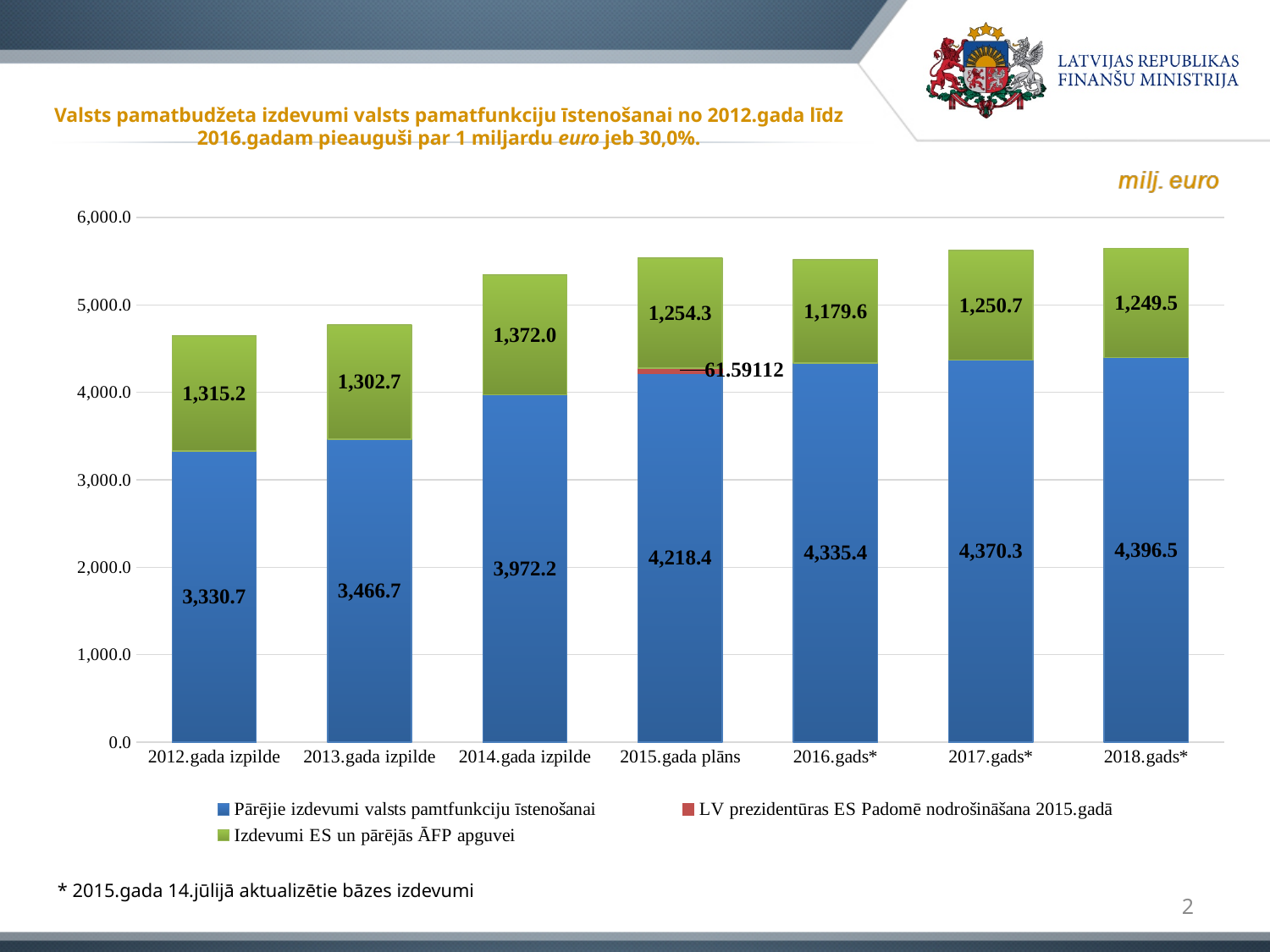
What is the total of the stacked bar for 2012.gada izpilde? 4,645.9 In which category is 'Izdevumi ES un pārējās ĀFP apguvei' highest? 2014.gada izpilde What is the value of 'Izdevumi ES un pārējās ĀFP apguvei' for 2017.gads*? 1,250.7 What is the value of 'LV prezidentūras ES Padomē nodrošināšana 2015.gadā' for 2015.gada plāns? 61.59112 What is the total of the stacked bar for 2016.gads*? 5,515.0 How many series does the legend list? 3 What is the difference between 'Pārējie izdevumi valsts pamtfunkciju īstenošanai' in 2018.gads* and in 2012.gada izpilde? 1,065.8 How many categories are shown on the x axis? 7 Which is larger: 'Izdevumi ES un pārējās ĀFP apguvei' in 2012.gada izpilde or in 2013.gada izpilde? 2012.gada izpilde What is the value of 'Pārējie izdevumi valsts pamtfunkciju īstenošanai' for 2014.gada izpilde? 3,972.2 In which category is 'Pārējie izdevumi valsts pamtfunkciju īstenošanai' lowest? 2012.gada izpilde In which category is 'Izdevumi ES un pārējās ĀFP apguvei' lowest? 2016.gads*